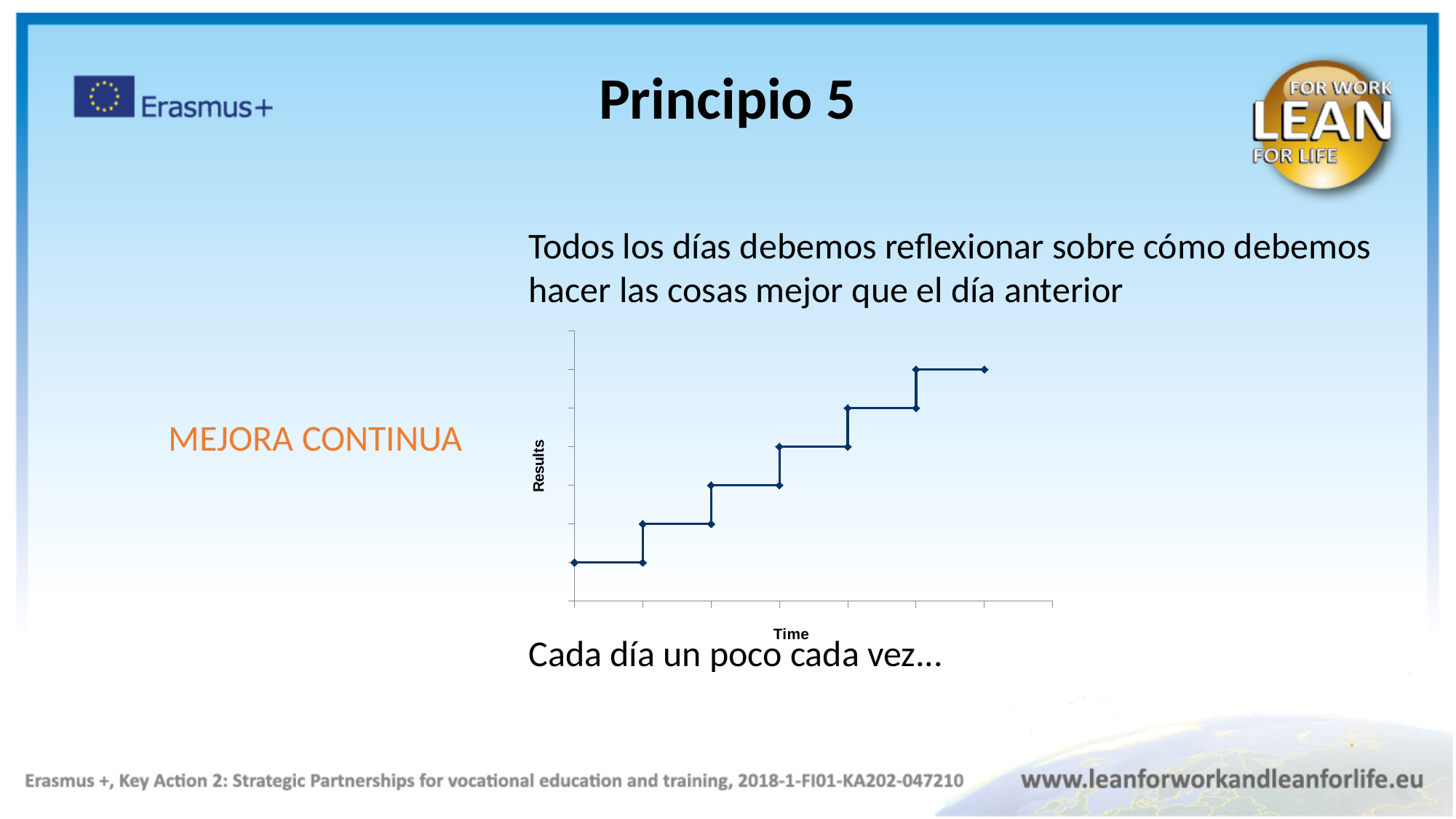
What kind of chart is shown on the slide? line chart How many upward steps does the line in the chart make? 5 Do the values in the chart rise or fall as you move along the x axis? rise What is the title of the vertical axis of the chart? Results What is the title of the horizontal axis of the chart? Time Is the last point of the line higher or lower than the first point? higher